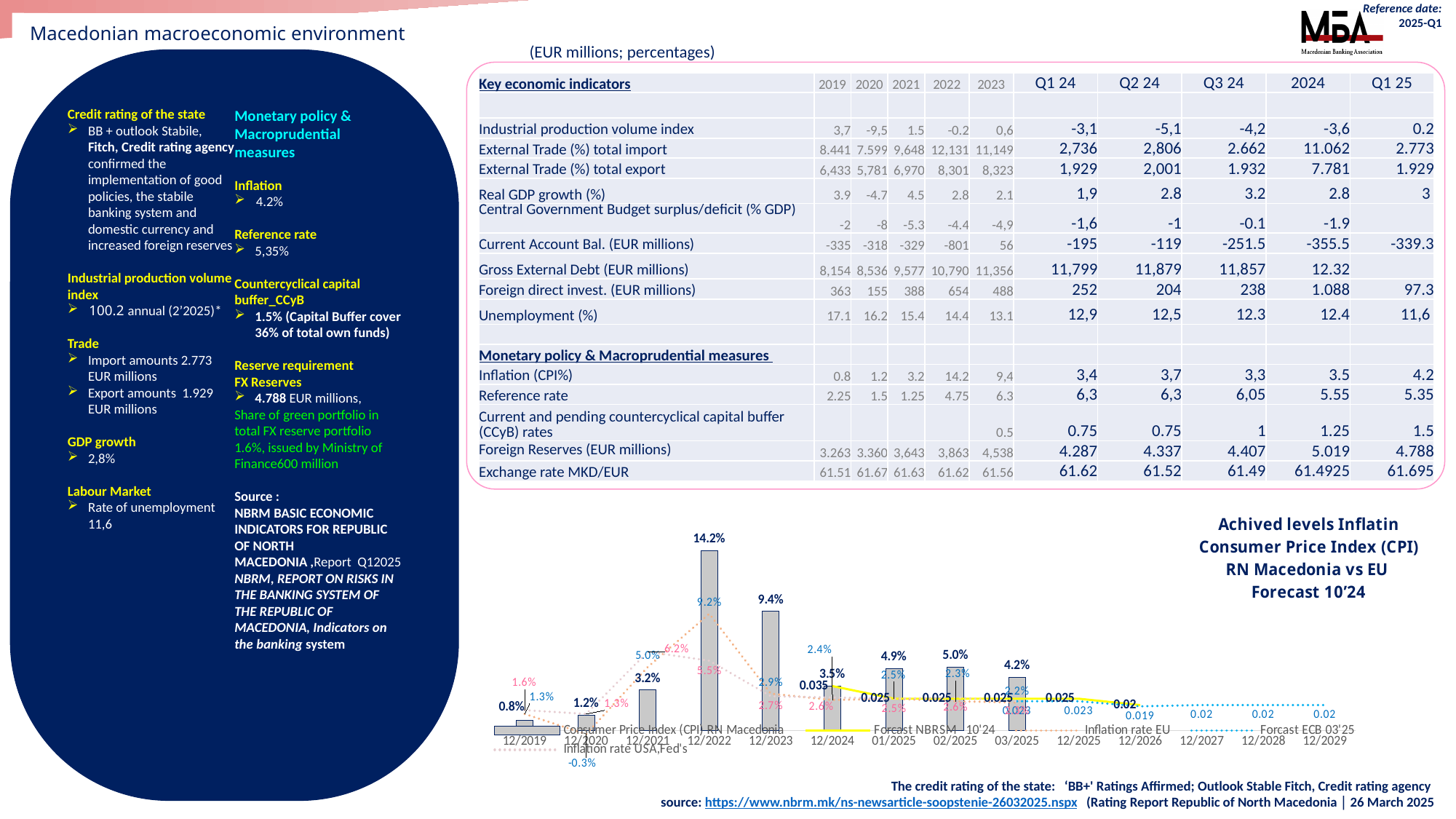
How many periods are shown on the x axis of the chart? 14 Does the CPI RN Macedonia value rise or fall from 12/2022 to 12/2024? fall What is the Forcast ECB 03'25 value shown at 12/2029? 0.02 How many series does the chart legend list? 5 What is the Consumer Price Index (CPI) RN Macedonia value for 12/2022? 14.2% In which period is the Consumer Price Index (CPI) RN Macedonia bar the highest? 12/2022 What is the Consumer Price Index (CPI) RN Macedonia value for 12/2023? 9.4% In which period is the Consumer Price Index (CPI) RN Macedonia bar the lowest? 12/2019 What is the Consumer Price Index (CPI) RN Macedonia value for 03/2025? 4.2% Which is larger, the CPI RN Macedonia value for 12/2021 or for 12/2024? 12/2024 What is the Forecast NBRSM 10'24 value shown at 12/2024? 0.035 What is the difference between the CPI RN Macedonia values for 12/2022 and 12/2023? 4.8 percentage points